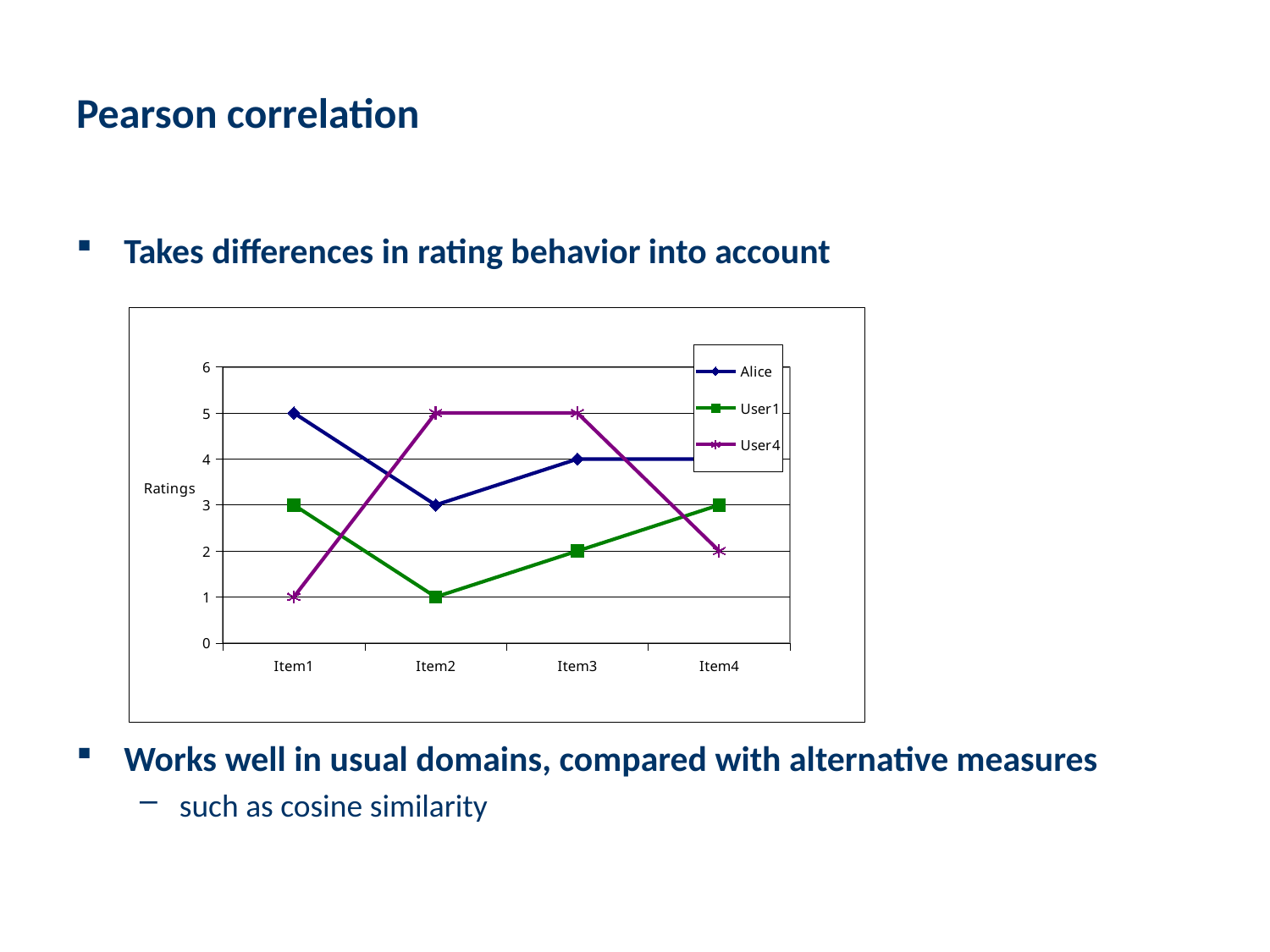
How many items are shown on the x axis? 4 What is the difference between Alice's and User1's ratings for Item3? 2 Which is larger for Item4: Alice's rating or User4's rating? Alice What is the label on the vertical axis? Ratings What kind of chart is shown on the slide? line chart What is User4's rating for Item3? 5 What is User1's rating for Item2? 1 Does User1's rating rise or fall from Item2 to Item4? rise For which item is User4's rating lowest? Item1 How many series does the legend list? 3 What is Alice's rating for Item1? 5 For which item is Alice's rating highest? Item1